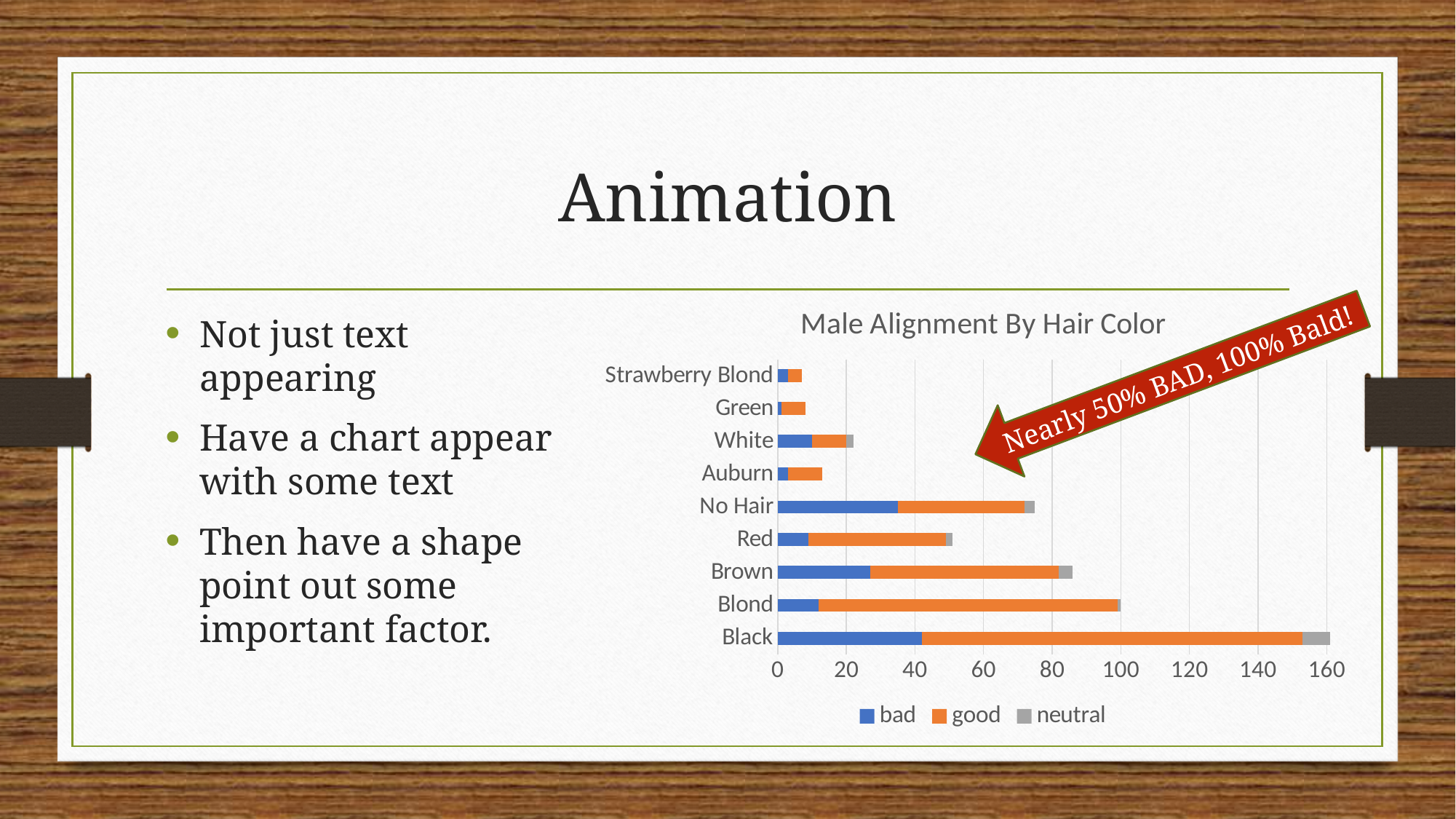
What is the title of the chart? Male Alignment By Hair Color Is the total bar length for Brown greater or less than 80? greater Is the total bar length for Black greater or less than 140? greater Which series in the legend is shown in orange? good Is the total bar length for No Hair greater or less than 80? less Which hair color has the longest total bar in the chart? Black How many series does the chart legend list? 3 What type of chart is shown on the slide? Stacked bar chart Which has a longer total bar, No Hair or Auburn? No Hair Which has a longer total bar, Brown or Red? Brown How many hair color categories are plotted in the chart? 9